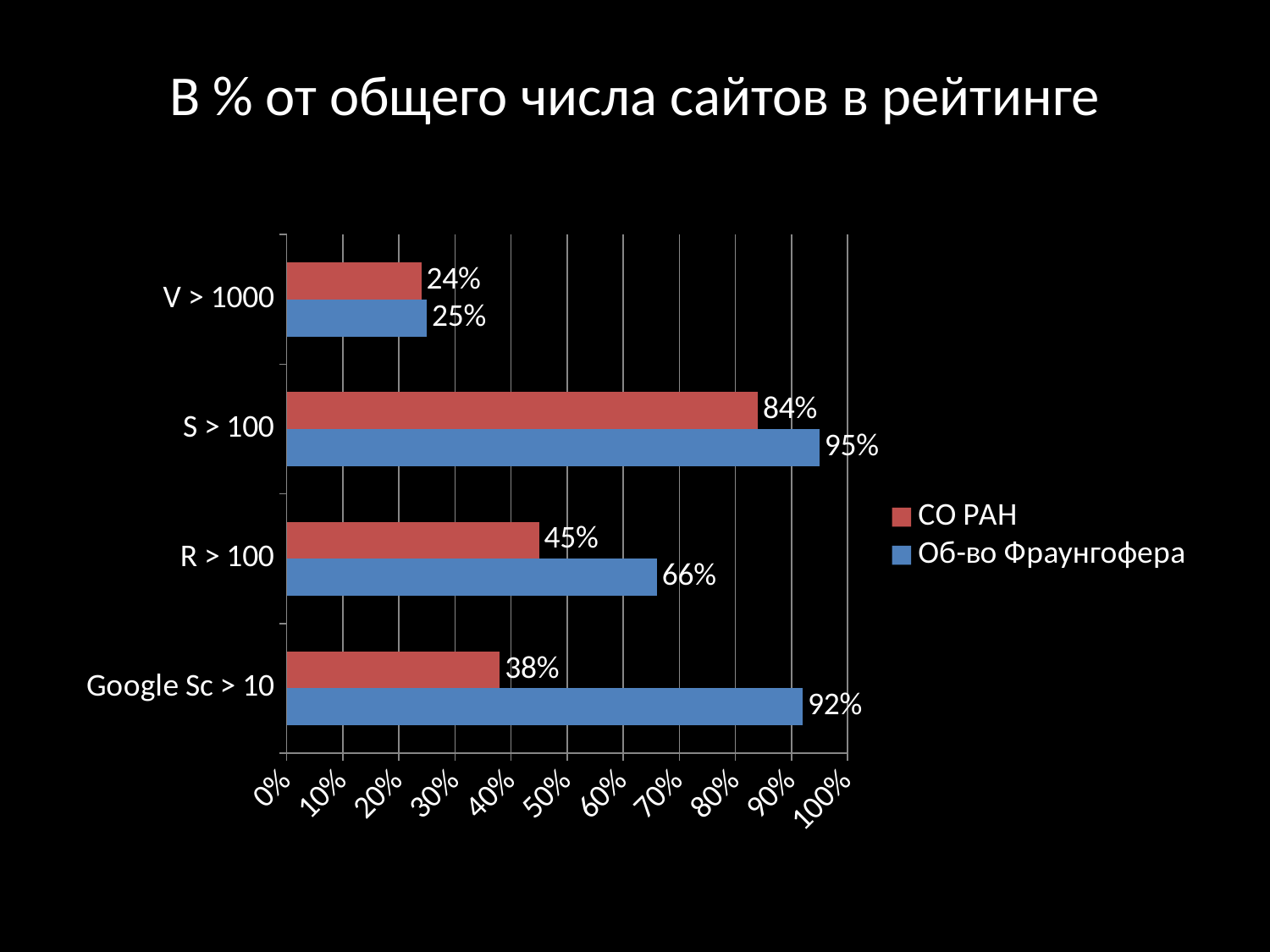
What is the value for Об-во Фраунгофера in the S > 100 category? 95% Which is larger in the R > 100 category: СО РАН or Об-во Фраунгофера? Об-во Фраунгофера Which category has the highest value for Об-во Фраунгофера? S > 100 What is the value for СО РАН in the Google Sc > 10 category? 38% How many series does the legend list? 2 What is the value for СО РАН in the R > 100 category? 45% Which category has the lowest value for СО РАН? V > 1000 What is the difference between Об-во Фраунгофера and СО РАН in the Google Sc > 10 category? 54% What kind of chart is shown on the slide? Bar chart How many categories are shown on the chart? 4 What is the title of the chart? В % от общего числа сайтов в рейтинге What is the value for Об-во Фраунгофера in the V > 1000 category? 25%